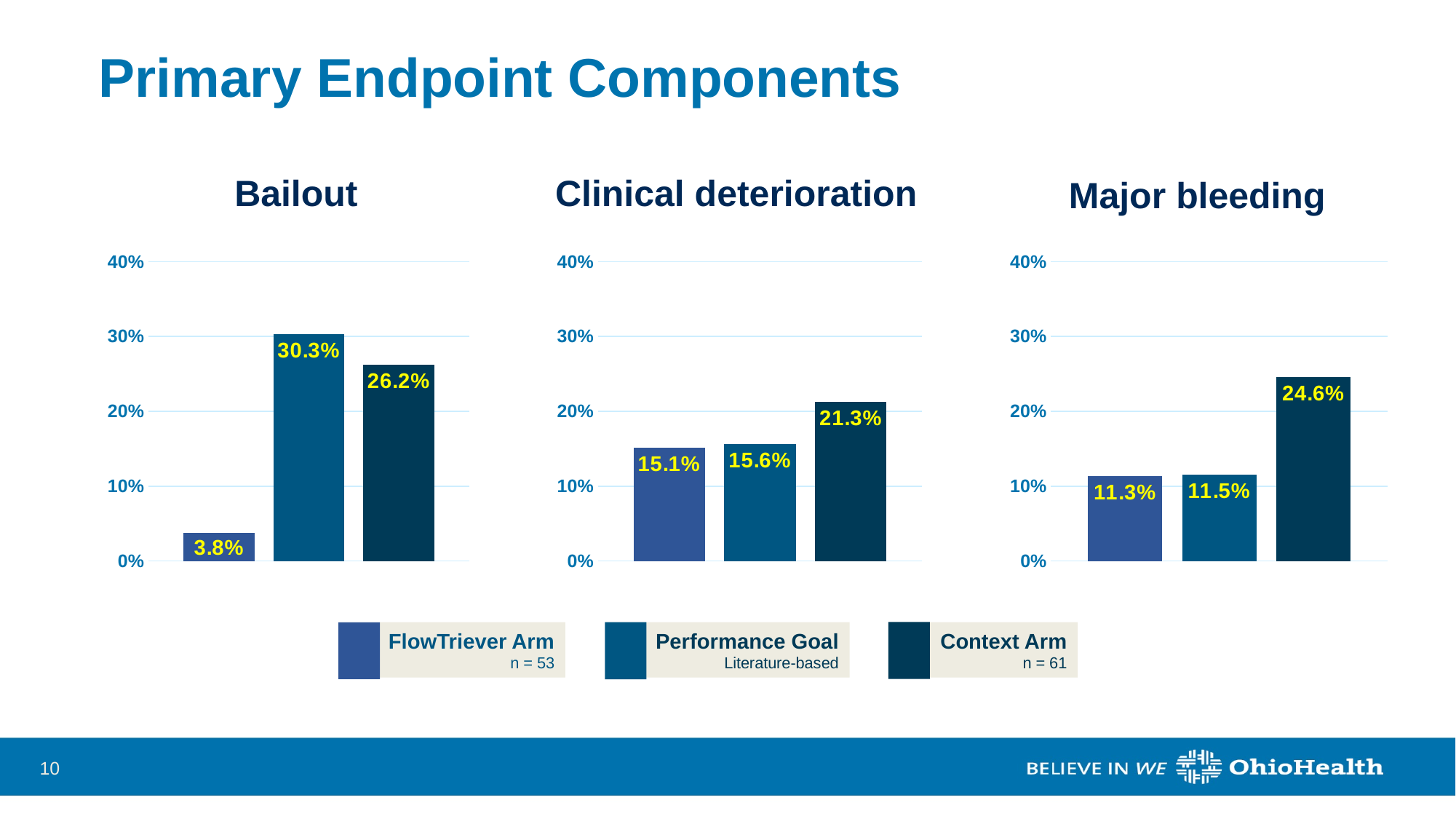
In the Bailout chart, which series has the highest value? Performance Goal In the Clinical deterioration chart, which is larger: the FlowTriever Arm value or the Context Arm value? Context Arm In the Clinical deterioration chart, what is the value for the Context Arm? 21.3% How many series does the legend list? 3 In the Major bleeding chart, what is the value for the FlowTriever Arm? 11.3% In the Bailout chart, what is the value for the FlowTriever Arm? 3.8% In the Bailout chart, what is the value for the Performance Goal? 30.3% In the Major bleeding chart, what is the difference between the Context Arm and the FlowTriever Arm values? 13.3% In the Clinical deterioration chart, which series has the lowest value? FlowTriever Arm In the Bailout chart, what is the difference between the Performance Goal and the Context Arm values? 4.1% What kind of chart is the Major bleeding chart? Bar chart In the Major bleeding chart, which series has the highest value? Context Arm